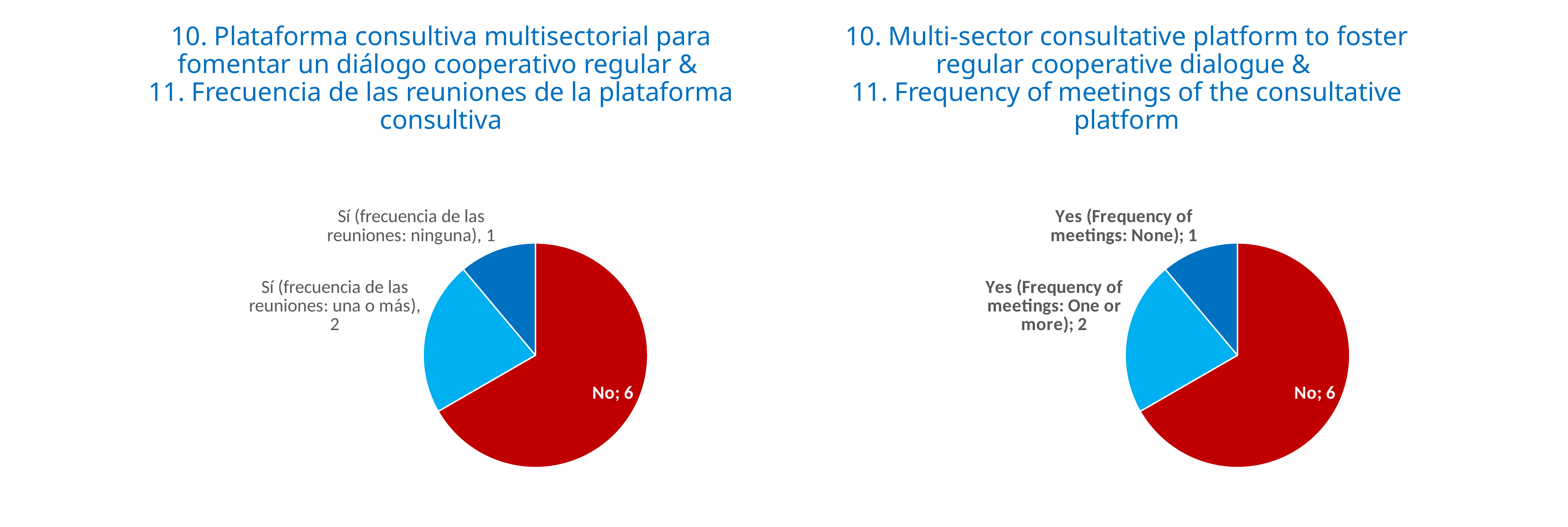
In the right-hand pie chart, which category has the smallest slice? Yes (Frequency of meetings: None) In the right-hand pie chart, what share of the total does the "No" slice represent? 6 out of 9 In the right-hand pie chart, what is the difference between the value for "No" and the value for "Yes (Frequency of meetings: One or more)"? 4 In the left-hand pie chart, which is larger: "No" or "Sí (frecuencia de las reuniones: ninguna)"? No In the left-hand pie chart (Plataforma consultiva multisectorial), what is the value for "Sí (frecuencia de las reuniones: una o más)"? 2 In the right-hand pie chart, what is the value for "Yes (Frequency of meetings: None)"? 1 How many slices does the right-hand pie chart have? 3 In the right-hand pie chart, which category has the largest slice? No In the right-hand pie chart, what colour is the "No" slice? Red In the right-hand pie chart (Multi-sector consultative platform), what is the value for "No"? 6 In the right-hand pie chart, what is the value for "Yes (Frequency of meetings: One or more)"? 2 What type of chart is shown on the left-hand side of the slide? Pie chart